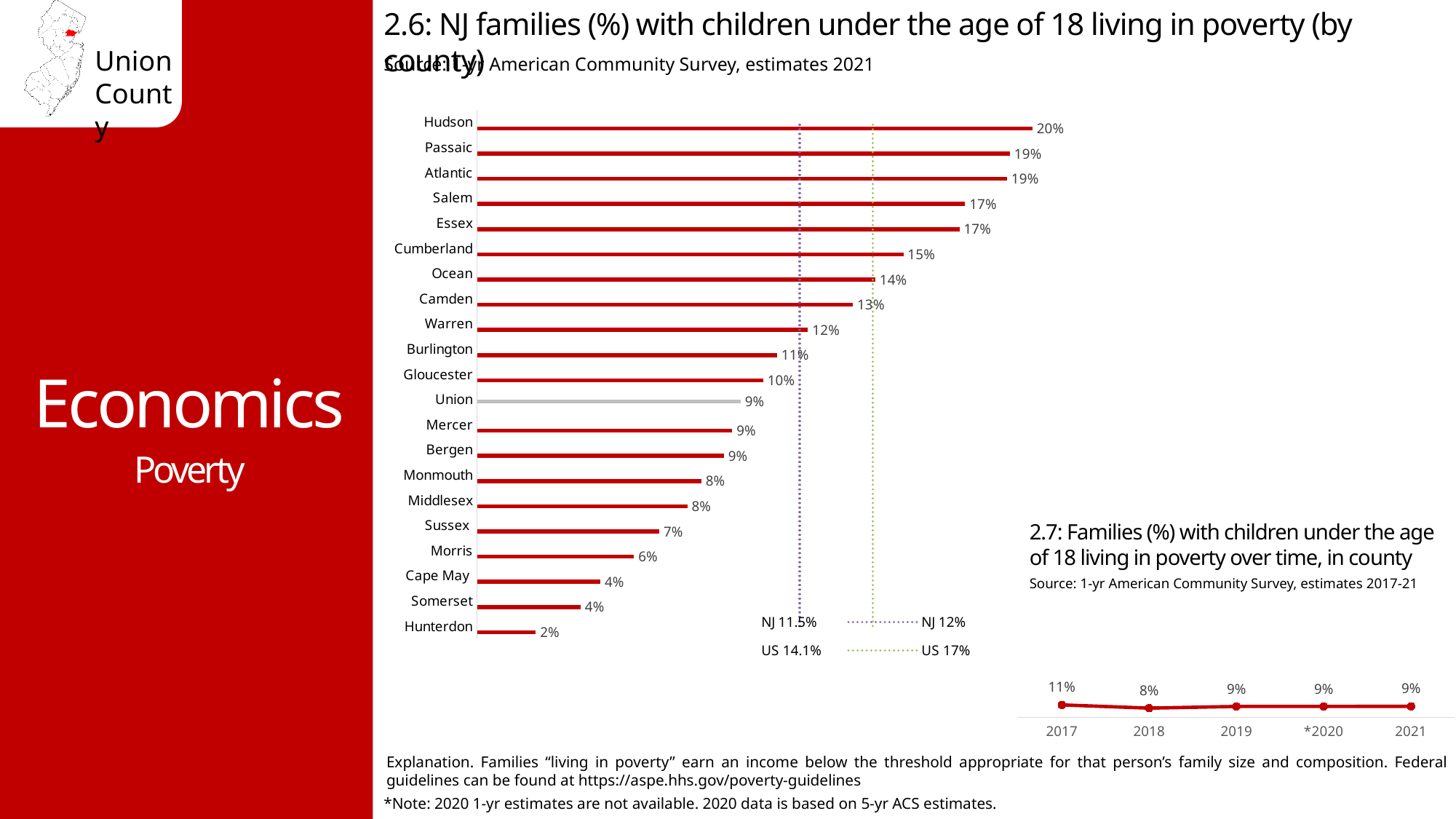
In chart 2.6, which county has the lowest value? Hunterdon In chart 2.6, what is the value for Hudson? 20% In chart 2.6, what is the value for Union? 9% In chart 2.6, how many counties are shown? 21 What kind of chart is chart 2.6? Bar chart In chart 2.7, which year has the lowest value? 2018 In chart 2.6, which county has the highest value? Hudson In chart 2.6, what is the difference between the values for Hudson and Hunterdon? 18% In chart 2.7, how many years are plotted? 5 In chart 2.6, which is larger, the value for Cumberland or the value for Camden? Cumberland In chart 2.7, what is the value for 2017? 11%